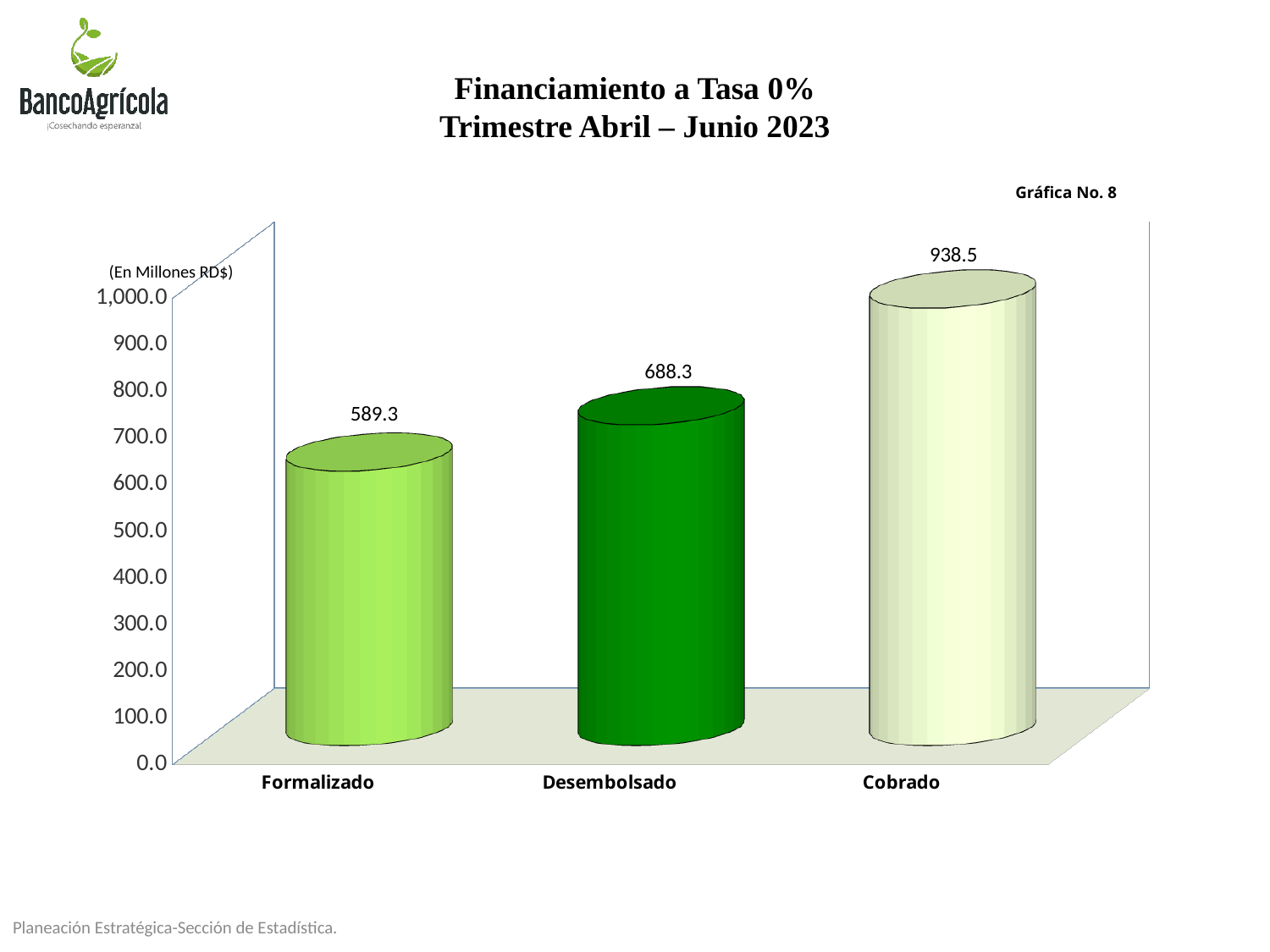
What is the value for Desembolsado? 688.3 Which category has the lowest value? Formalizado Which category has the highest value? Cobrado What unit is stated for the values on the chart? En Millones RD$ What kind of chart is shown on the slide? bar chart Which is larger, the value for Desembolsado or the value for Cobrado? Cobrado Is the value for Cobrado greater or less than 900.0? greater How many categories are shown on the chart? 3 What is the value for Formalizado? 589.3 What is the difference between the values for Cobrado and Formalizado? 349.2 What is the difference between the values for Desembolsado and Formalizado? 99.0 What is the value for Cobrado? 938.5